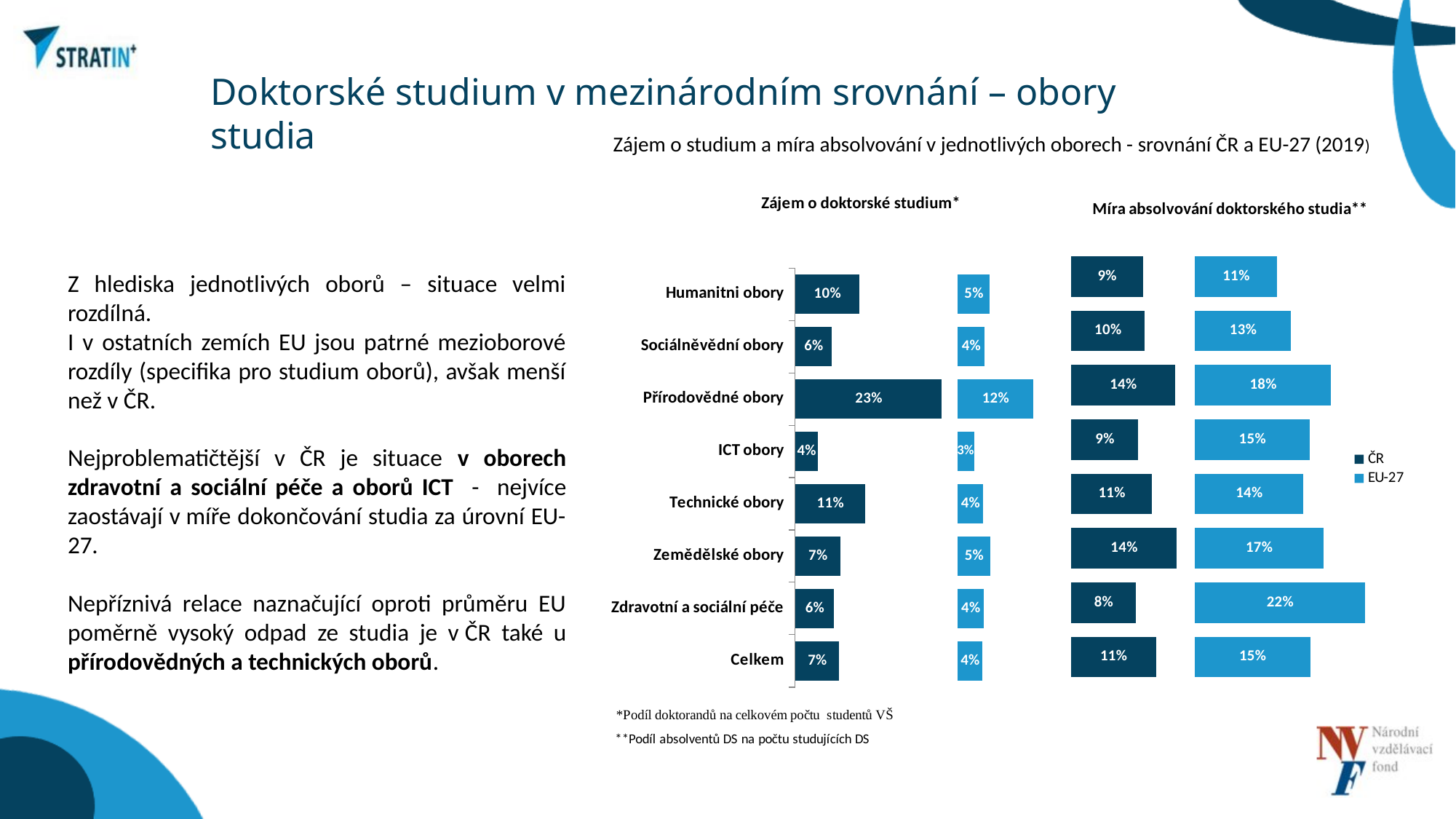
How many categories are shown on the y axis of the charts? 8 In the 'Zájem o doktorské studium' chart, what is the value for ČR for Přírodovědné obory? 23% How many series does the legend list? 2 What type of chart is used on the slide? Bar chart In the 'Zájem o doktorské studium' chart, which is larger for Technické obory: the ČR value or the EU-27 value? ČR In the 'Míra absolvování doktorského studia' chart, what is the difference between the EU-27 and ČR values for Zdravotní a sociální péče? 14 percentage points In the 'Zájem o doktorské studium' chart, which category has the lowest ČR value? ICT obory In the 'Zájem o doktorské studium' chart, what is the EU-27 value for Celkem? 4% In the 'Zájem o doktorské studium' chart, what is the difference between the ČR and EU-27 values for Přírodovědné obory? 11 percentage points In the 'Míra absolvování doktorského studia' chart, which is larger for ICT obory: the ČR value or the EU-27 value? EU-27 In the 'Míra absolvování doktorského studia' chart, what is the EU-27 value for Zdravotní a sociální péče? 22% In the 'Míra absolvování doktorského studia' chart, which category has the highest ČR value? Přírodovědné obory and Zemědělské obory (14%)